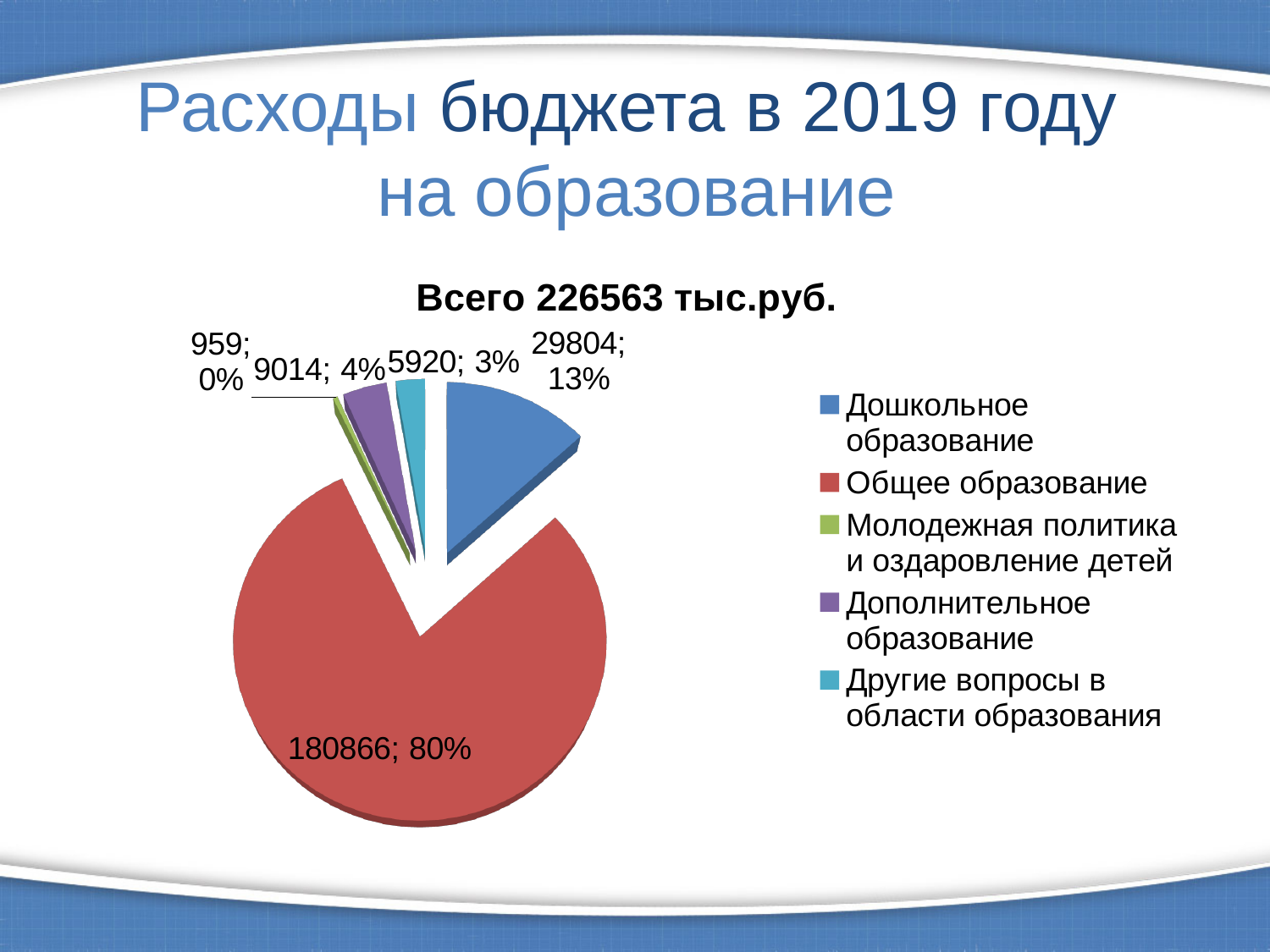
What value is shown for Дошкольное образование? 29804 What kind of chart is shown on the slide? Pie chart What share of the pie does Общее образование take? 80% What share of the pie does Дошкольное образование take? 13% Which category has the largest slice? Общее образование Which category has the smallest slice? Молодежная политика и оздаровление детей What value is shown for Общее образование? 180866 What value is shown for Дополнительное образование? 9014 What is the title of the chart? Всего 226563 тыс.руб. What value is shown for Другие вопросы в области образования? 5920 How many categories does the legend list? 5 What value is shown for Молодежная политика и оздаровление детей? 959